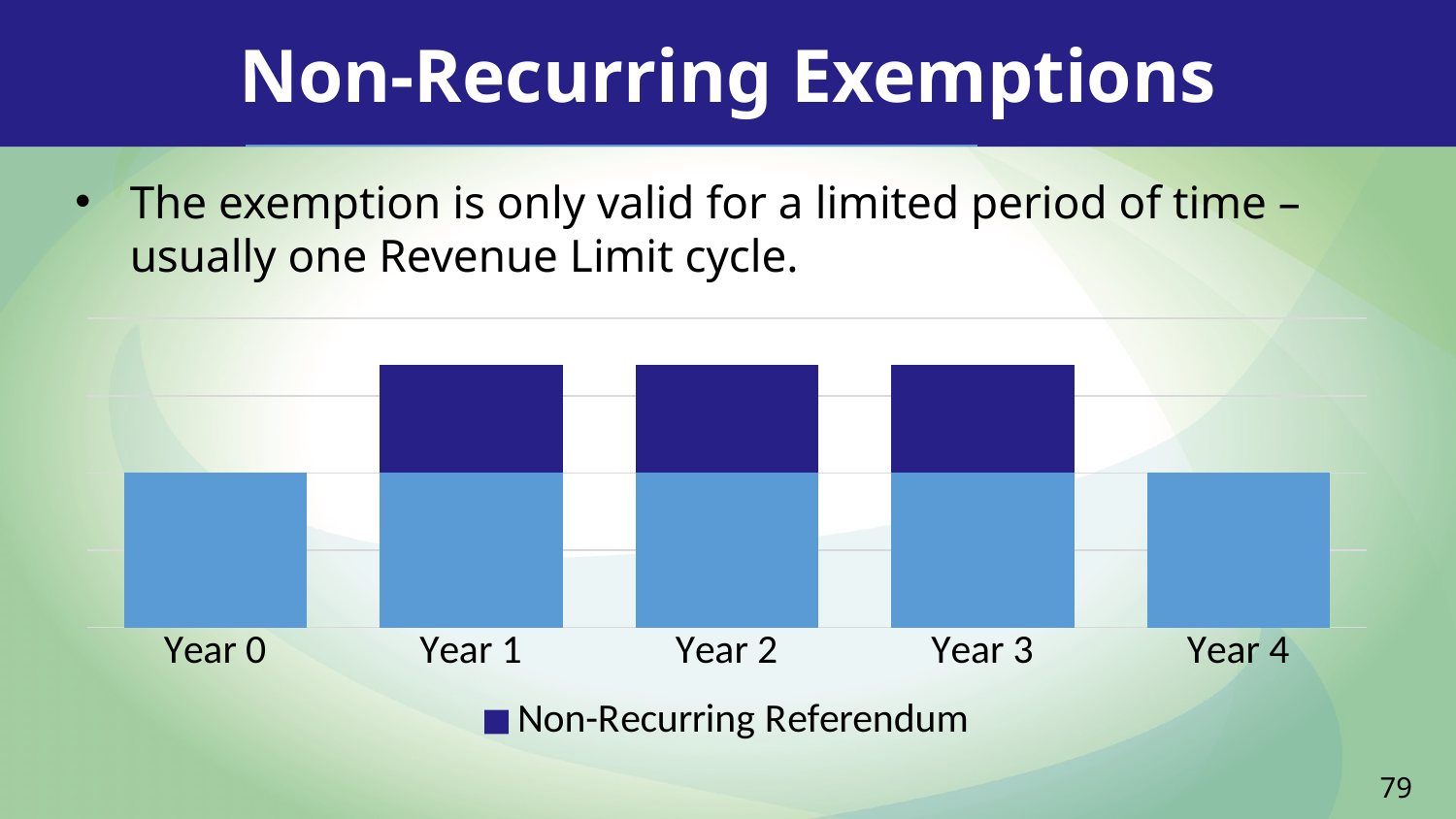
Does the total bar height rise or fall from Year 3 to Year 4? Fall Which is larger, the total bar for Year 1 or the total bar for Year 0? Year 1 Does the total bar height rise or fall from Year 0 to Year 1? Rise How many series does the chart's legend list? 1 How many bars include a dark blue Non-Recurring Referendum segment? 3 What kind of chart is shown on the slide? Bar chart Which is larger, the total bar for Year 3 or the total bar for Year 4? Year 3 Which categories have a dark blue Non-Recurring Referendum segment stacked on top of the bar? Year 1, Year 2, Year 3 How many categories are shown on the x axis of the chart? 5 What is the label of the first category on the x axis? Year 0 What is the name of the series listed in the chart's legend? Non-Recurring Referendum Which is larger, the total bar for Year 2 or the total bar for Year 4? Year 2